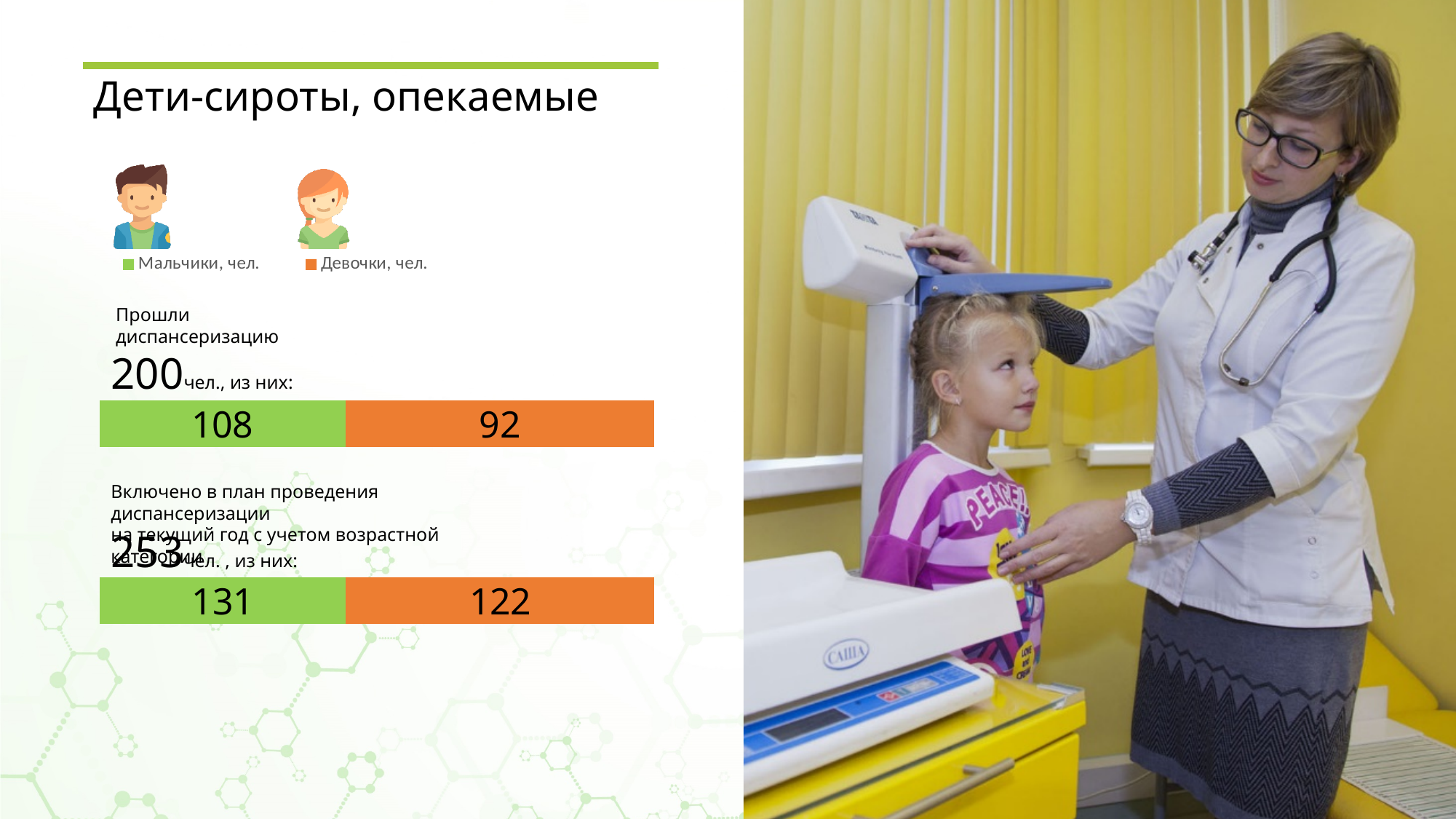
What type of chart is used for the upper chart (Прошли диспансеризацию)? Stacked bar chart In the lower bar chart, what is the total of the stacked bar? 253 In the upper bar chart, which is larger, Мальчики or Девочки? Мальчики In the lower bar chart (Включено в план проведения диспансеризации), what is the value for Девочки? 122 How many series does the legend list for the charts on this slide? 2 In the upper bar chart, what is the total of the stacked bar? 200 In the upper bar chart, what is the difference between the values for Мальчики and Девочки? 16 In the lower bar chart (Включено в план проведения диспансеризации), what is the value for Мальчики? 131 In the upper bar chart (Прошли диспансеризацию), what is the value for Мальчики? 108 In the lower bar chart, which series has the higher value? Мальчики In the upper bar chart (Прошли диспансеризацию), what is the value for Девочки? 92 In the lower bar chart, what is the difference between the values for Мальчики and Девочки? 9